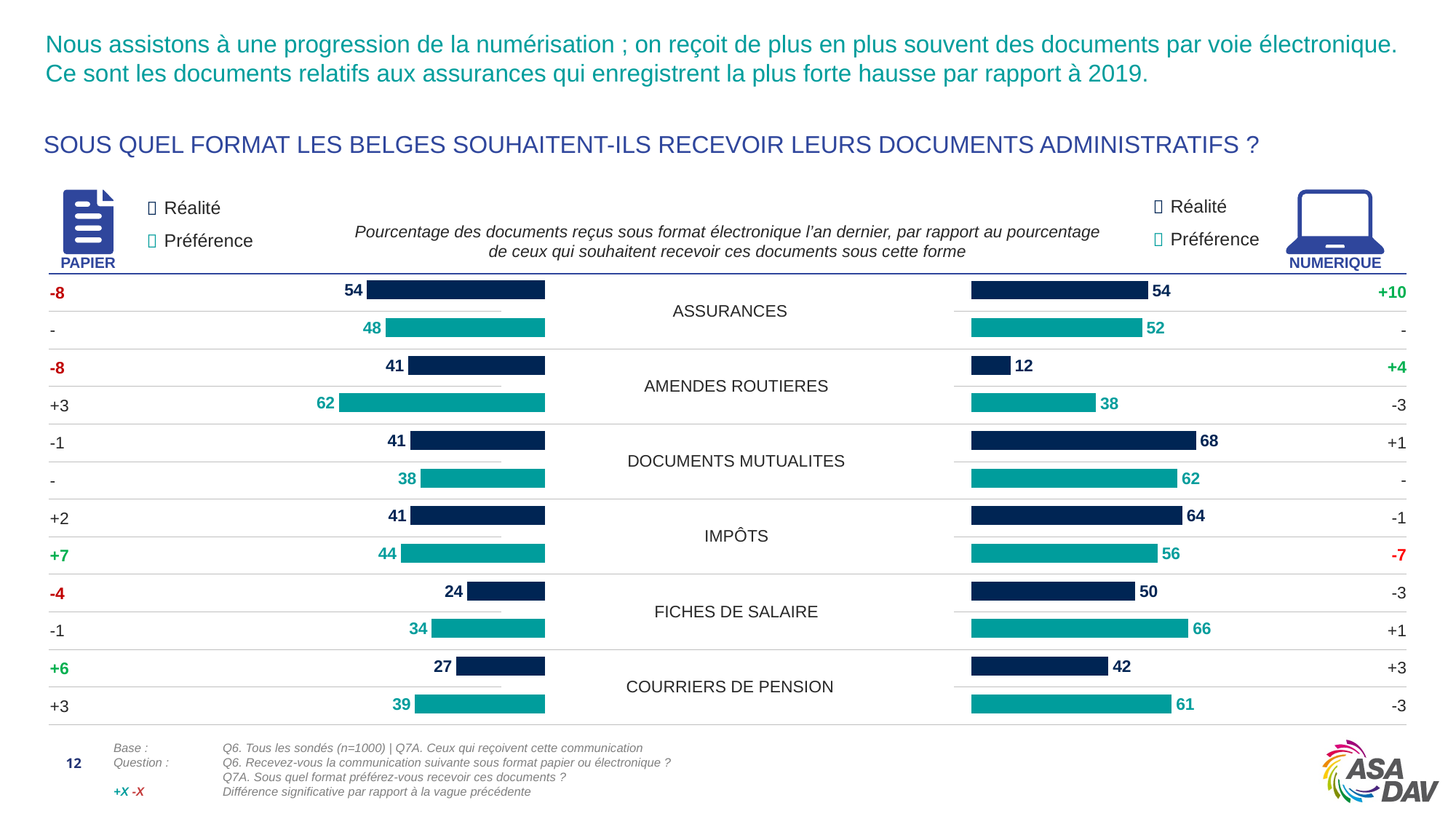
In the PAPIER chart, what is the difference between the Préférence and Réalité values for AMENDES ROUTIERES? 21 In the PAPIER chart, which is larger for FICHES DE SALAIRE: the Réalité value or the Préférence value? Préférence In the NUMERIQUE chart, what is the difference between the Réalité and Préférence values for IMPÔTS? 8 In the NUMERIQUE chart, what is the Réalité value for AMENDES ROUTIERES? 12 In the NUMERIQUE chart, what is the Préférence value for FICHES DE SALAIRE? 66 In the PAPIER chart, which category has the highest Préférence value? AMENDES ROUTIERES In the NUMERIQUE chart, which category has the highest Réalité value? DOCUMENTS MUTUALITES What type of chart is used to show the PAPIER and NUMERIQUE data? Bar chart How many series does the legend of the PAPIER chart list? 2 In the PAPIER chart, what is the Réalité value for ASSURANCES? 54 How many document categories are shown in the charts? 6 In the NUMERIQUE chart, which category has the lowest Réalité value? AMENDES ROUTIERES